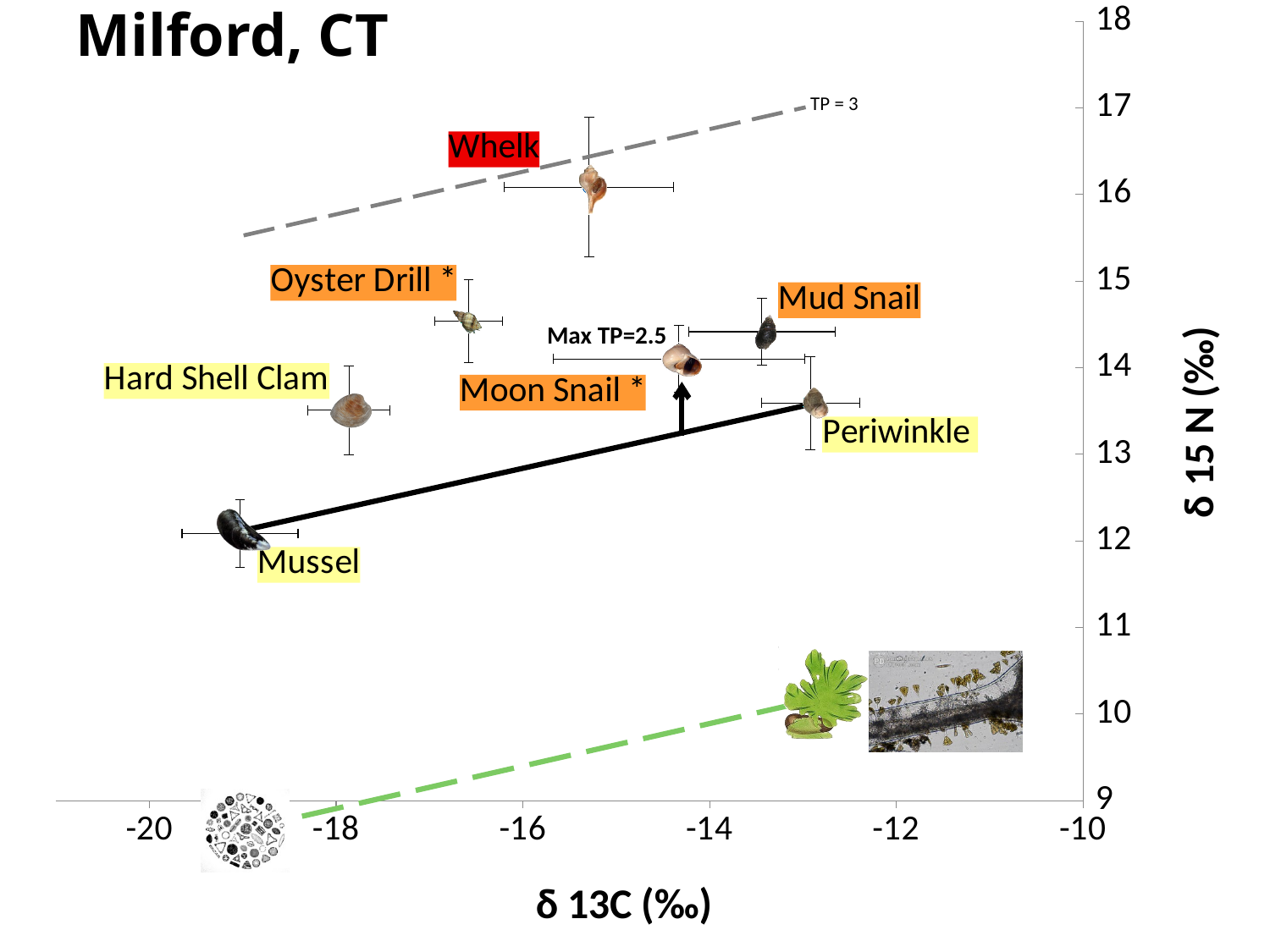
Which species has the most negative δ 13C value? Mussel Which species has the lowest δ 15 N value? Mussel What is the label on the y axis of the chart? δ 15 N (‰) Which species has the highest δ 15 N value? Whelk Is the δ 15 N value for Whelk greater or less than 15? greater Is the δ 13C value for Periwinkle greater or less than -14? greater What is the title of the chart? Milford, CT What kind of chart is shown on the slide? scatter plot Is the δ 15 N value for Mussel greater or less than 13? less Which has a higher δ 15 N value, Oyster Drill or Hard Shell Clam? Oyster Drill How many labeled species points are plotted on the chart? 7